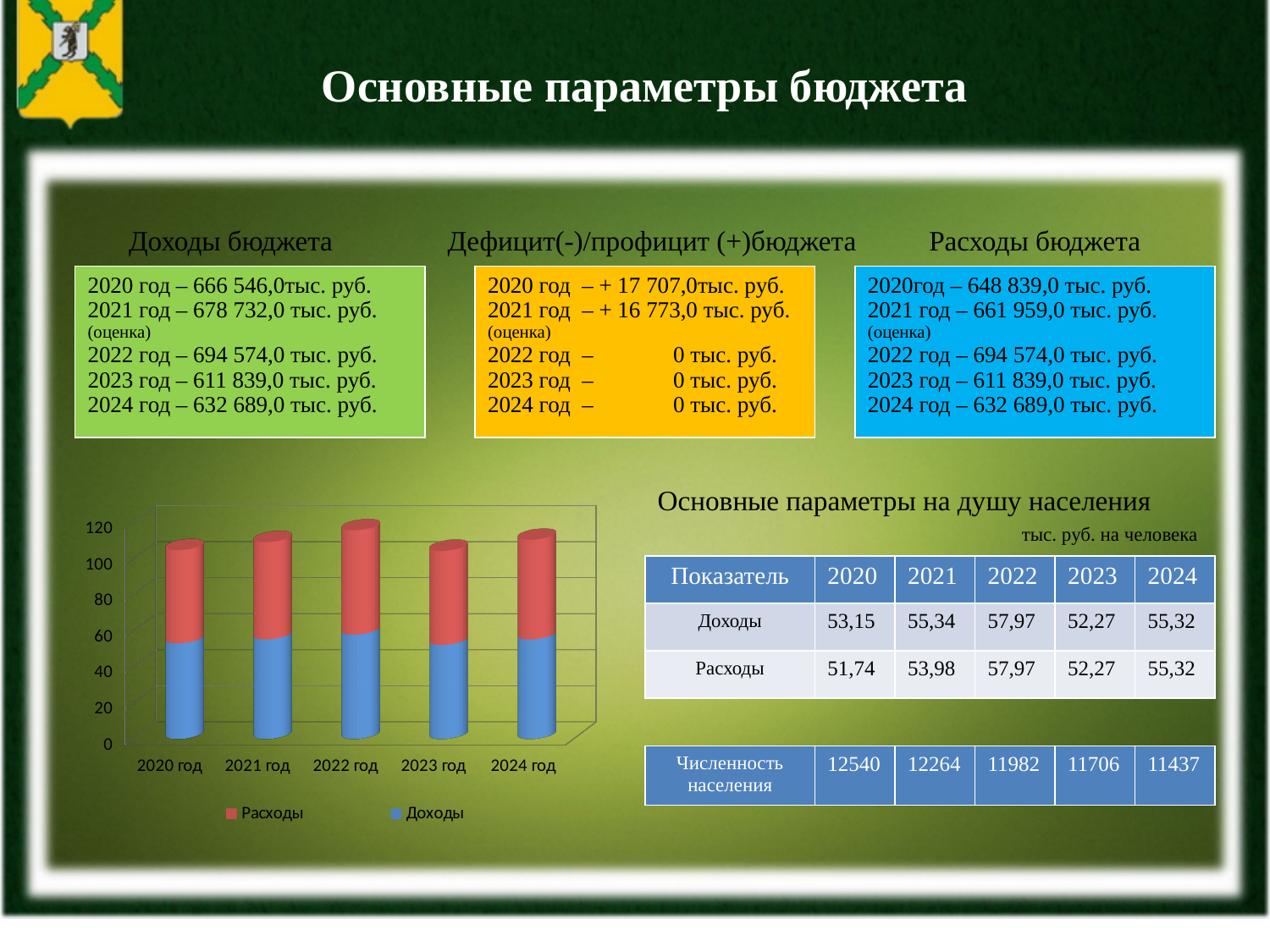
How many year categories are shown on the x axis of the bar chart? 5 In the bar chart, is the total stacked bar for 2023 год greater or less than 120? less What is the highest tick value shown on the vertical axis of the bar chart? 120 In the bar chart, is the value for Доходы in 2022 год greater or less than 40? greater In the bar chart, is the value for Доходы in 2020 год greater or less than 60? less How many series does the legend of the bar chart list? 2 What is the first year category on the x axis of the bar chart? 2020 год In the bar chart, which year has the tallest stacked bar? 2022 год Which series is shown in red in the bar chart? Расходы What kind of chart is shown on the slide? bar chart Which series is shown in blue in the bar chart? Доходы